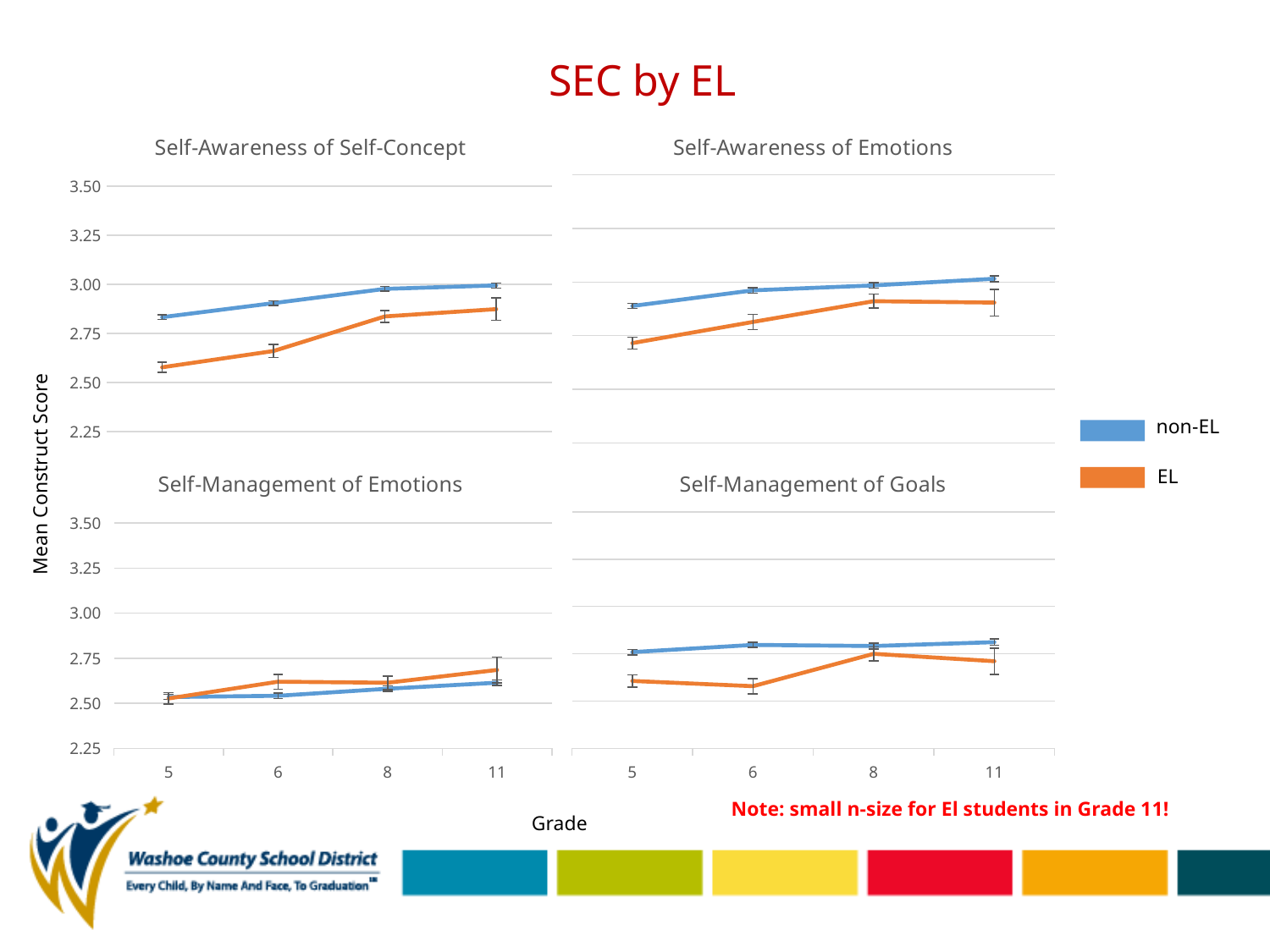
In the Self-Awareness of Self-Concept chart, which group has the higher value at grade 5, non-EL or EL? non-EL In the Self-Awareness of Emotions chart, is the EL value at grade 5 greater or less than 2.75? less In the Self-Awareness of Self-Concept chart, is the EL value at grade 5 greater or less than 2.75? less What is the label on the vertical axis? Mean Construct Score What colour represents the EL group in the legend? orange In the Self-Management of Goals chart, is the non-EL value at grade 5 greater or less than 2.50? greater In the Self-Awareness of Self-Concept chart, at which grade is the EL value lowest? 5 How many series does the legend list? 2 In the Self-Management of Emotions chart, which group has the higher value at grade 6, non-EL or EL? EL In the Self-Management of Goals chart, how many grade levels are plotted along the x axis? 4 What kind of chart is used for the Self-Awareness of Self-Concept panel? line chart In the Self-Awareness of Self-Concept chart, does the non-EL line rise or fall from grade 5 to grade 11? rise